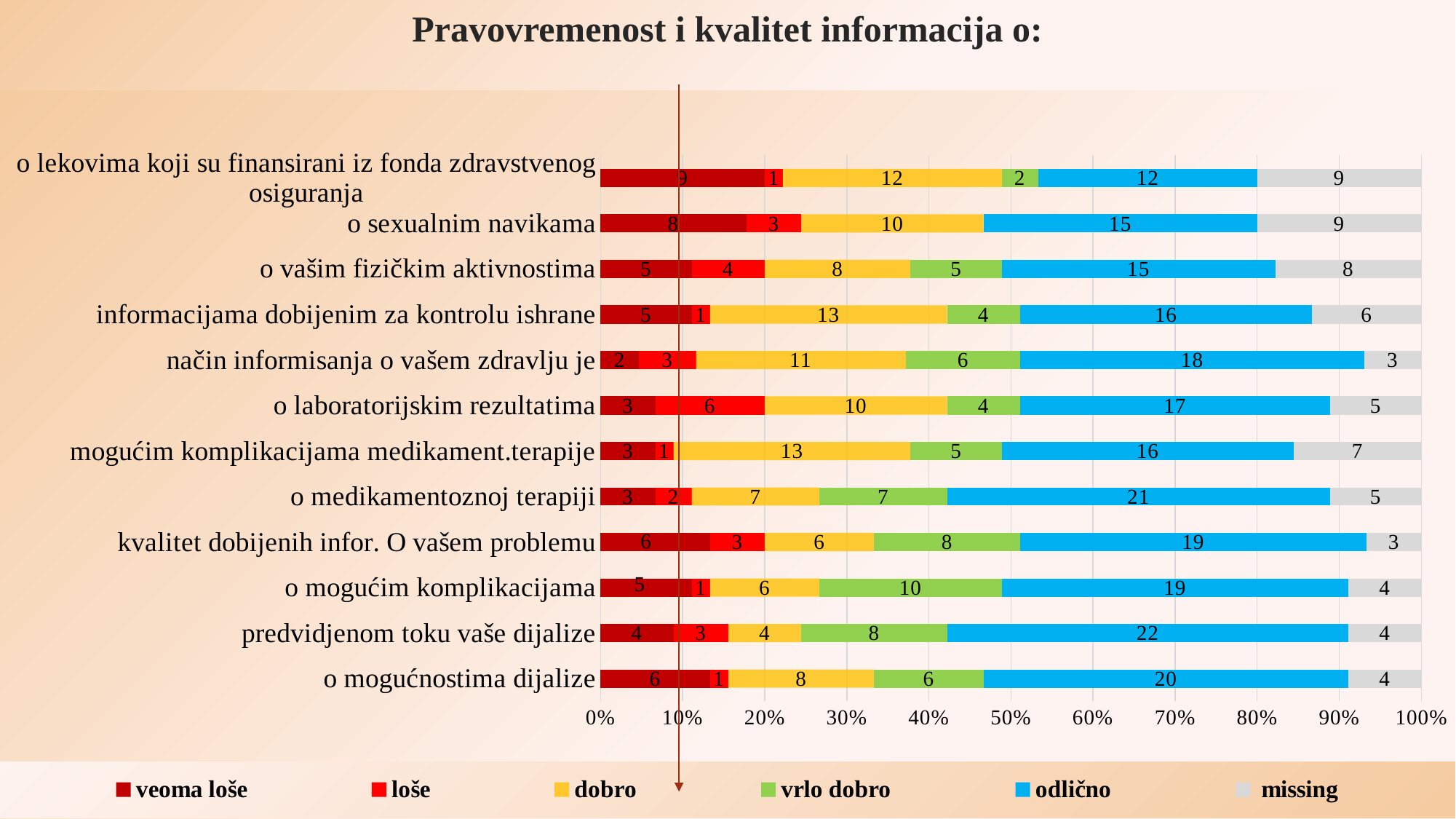
What is the difference between the 'odlično' values for 'o medikamentoznoj terapiji' and 'o laboratorijskim rezultatima'? 4 Which category has the highest 'veoma loše' value? o lekovima koji su finansirani iz fonda zdravstvenog osiguranja How many categories are plotted on the chart? 12 How many series does the legend list? 6 What kind of chart is shown on the slide? stacked bar chart What is the total of all segments in the bar for 'o mogućnostima dijalize'? 45 Which is larger: the 'vrlo dobro' value for 'o mogućim komplikacijama' or for 'kvalitet dobijenih infor. O vašem problemu'? o mogućim komplikacijama What is the 'odlično' value for 'predvidjenom toku vaše dijalize'? 22 What is the 'dobro' value for 'informacijama dobijenim za kontrolu ishrane'? 13 What is the title of the chart? Pravovremenost i kvalitet informacija o: Which category has the highest 'odlično' value? predvidjenom toku vaše dijalize What is the 'missing' value for 'o sexualnim navikama'? 9